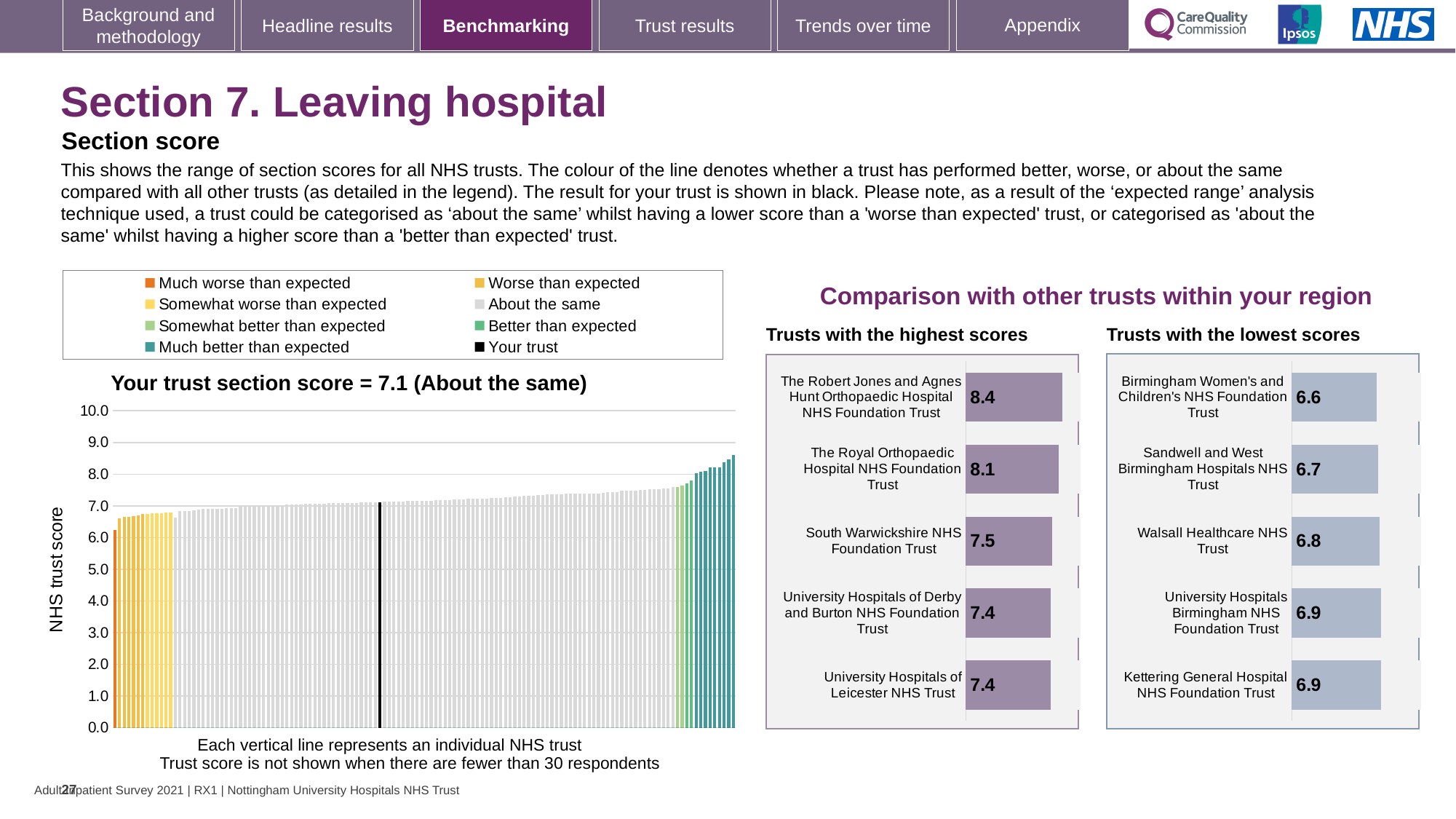
In the 'Your trust section score' chart, is the value of the rightmost (highest) bar greater or less than 8.0? greater In the 'Trusts with the highest scores' chart, how many trusts are shown? 5 In the 'Trusts with the lowest scores' chart, what is the score for Walsall Healthcare NHS Trust? 6.8 In the 'Trusts with the highest scores' chart, what is the score for The Robert Jones and Agnes Hunt Orthopaedic Hospital NHS Foundation Trust? 8.4 In the 'Your trust section score' chart, do the trust scores rise or fall from left to right along the x axis? rise In the 'Your trust section score' chart, is the value of the leftmost (lowest) bar greater or less than 7.0? less How many entries does the legend above the 'Your trust section score' chart list? 8 In the 'Trusts with the highest scores' chart, what is the difference between the scores of The Robert Jones and Agnes Hunt Orthopaedic Hospital NHS Foundation Trust and South Warwickshire NHS Foundation Trust? 0.9 In the 'Trusts with the lowest scores' chart, which has the larger score: Sandwell and West Birmingham Hospitals NHS Trust or Kettering General Hospital NHS Foundation Trust? Kettering General Hospital NHS Foundation Trust In the 'Your trust section score' chart, what kind of chart is used to show the trust scores? bar chart In the 'Trusts with the lowest scores' chart, which trust has the lowest score? Birmingham Women's and Children's NHS Foundation Trust In the 'Your trust section score' chart, what is the section score for your trust? 7.1